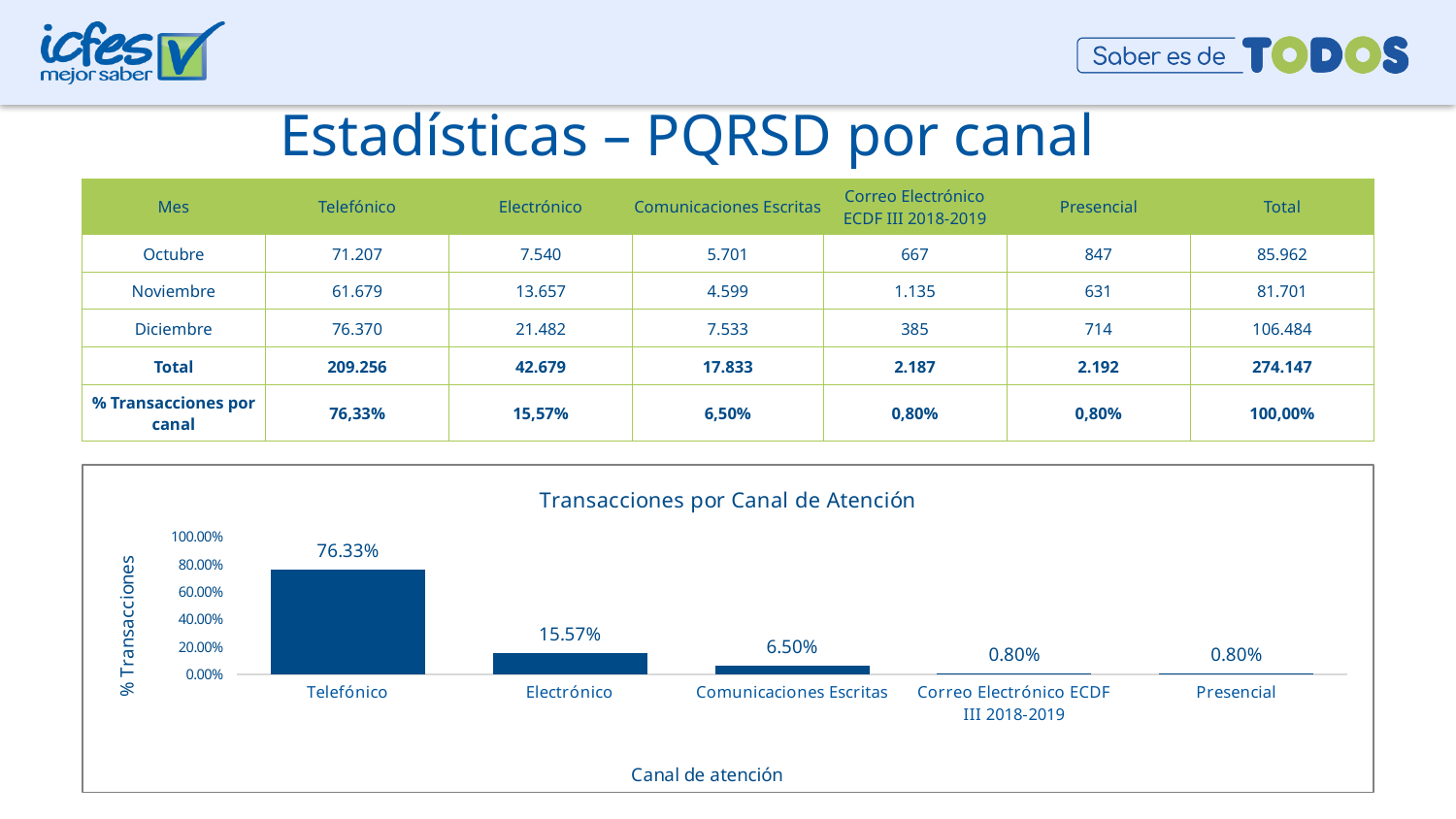
What is the value shown for Comunicaciones Escritas in the chart? 6.50% Which is larger, the value for Electrónico or the value for Comunicaciones Escritas? Electrónico What kind of chart is shown on the slide? Bar chart What is the value shown for Telefónico in the chart? 76.33% What is the difference between the values for Electrónico and Comunicaciones Escritas? 9.07% How many channels are shown on the x axis of the chart? 5 What is the difference between the values for Telefónico and Electrónico? 60.76% What is the value shown for Presencial in the chart? 0.80% What is the title of the chart? Transacciones por Canal de Atención Which channel has the highest value in the chart? Telefónico Is the value for Telefónico greater or less than 60.00%? greater What is the value shown for Electrónico in the chart? 15.57%